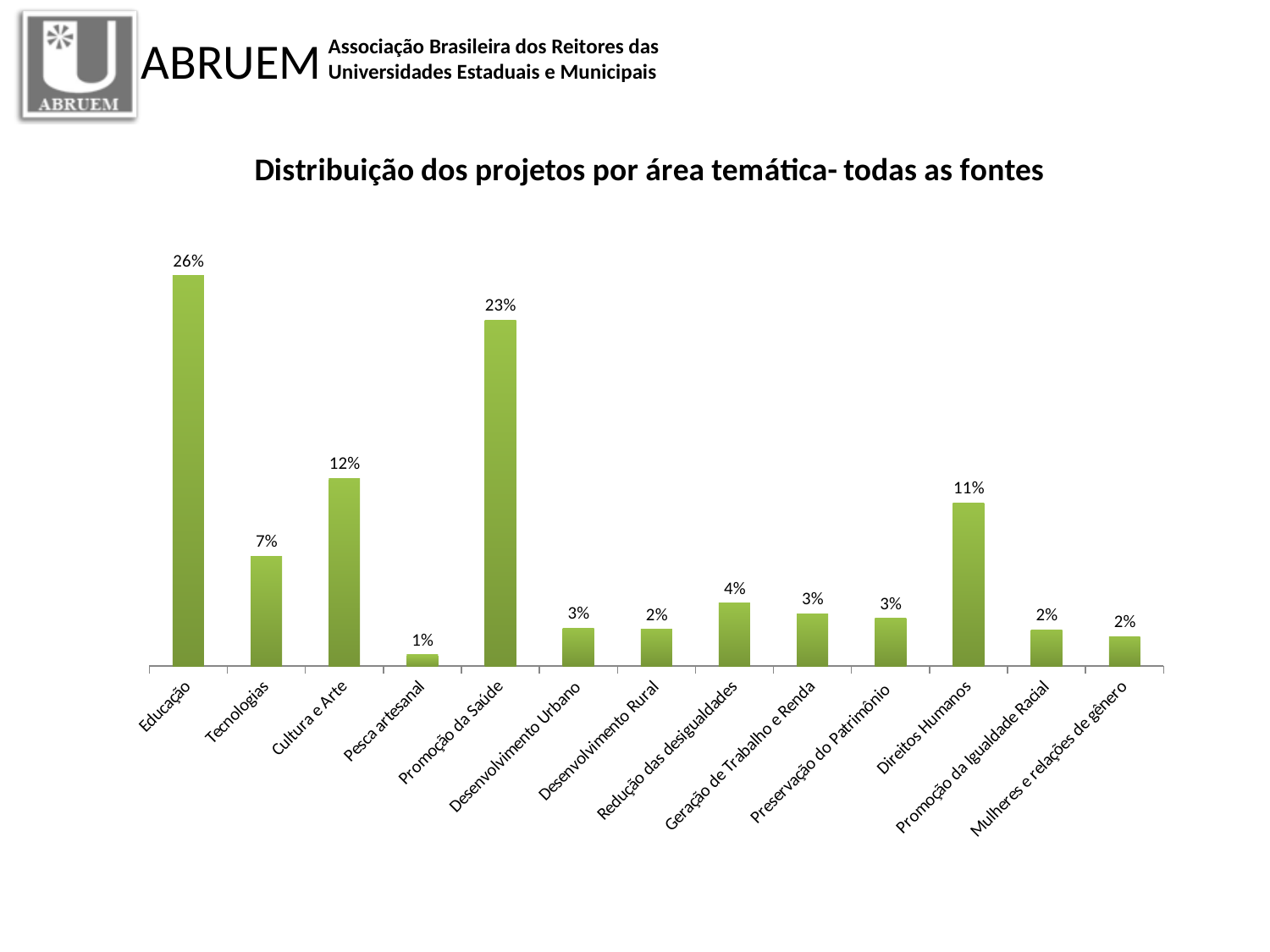
What is the value for Promoção da Saúde? 23% What is the value for Pesca artesanal? 1% Which category has the highest value? Educação What kind of chart is this? Bar chart Which is larger, the value for Cultura e Arte or the value for Direitos Humanos? Cultura e Arte What is the difference between the values for Cultura e Arte and Tecnologias? 5% What is the title of the chart? Distribuição dos projetos por área temática- todas as fontes How many categories are shown on the x axis? 13 Which category has the lowest value? Pesca artesanal What is the value for Educação? 26% What is the difference between the values for Educação and Promoção da Saúde? 3% What is the value for Direitos Humanos? 11%